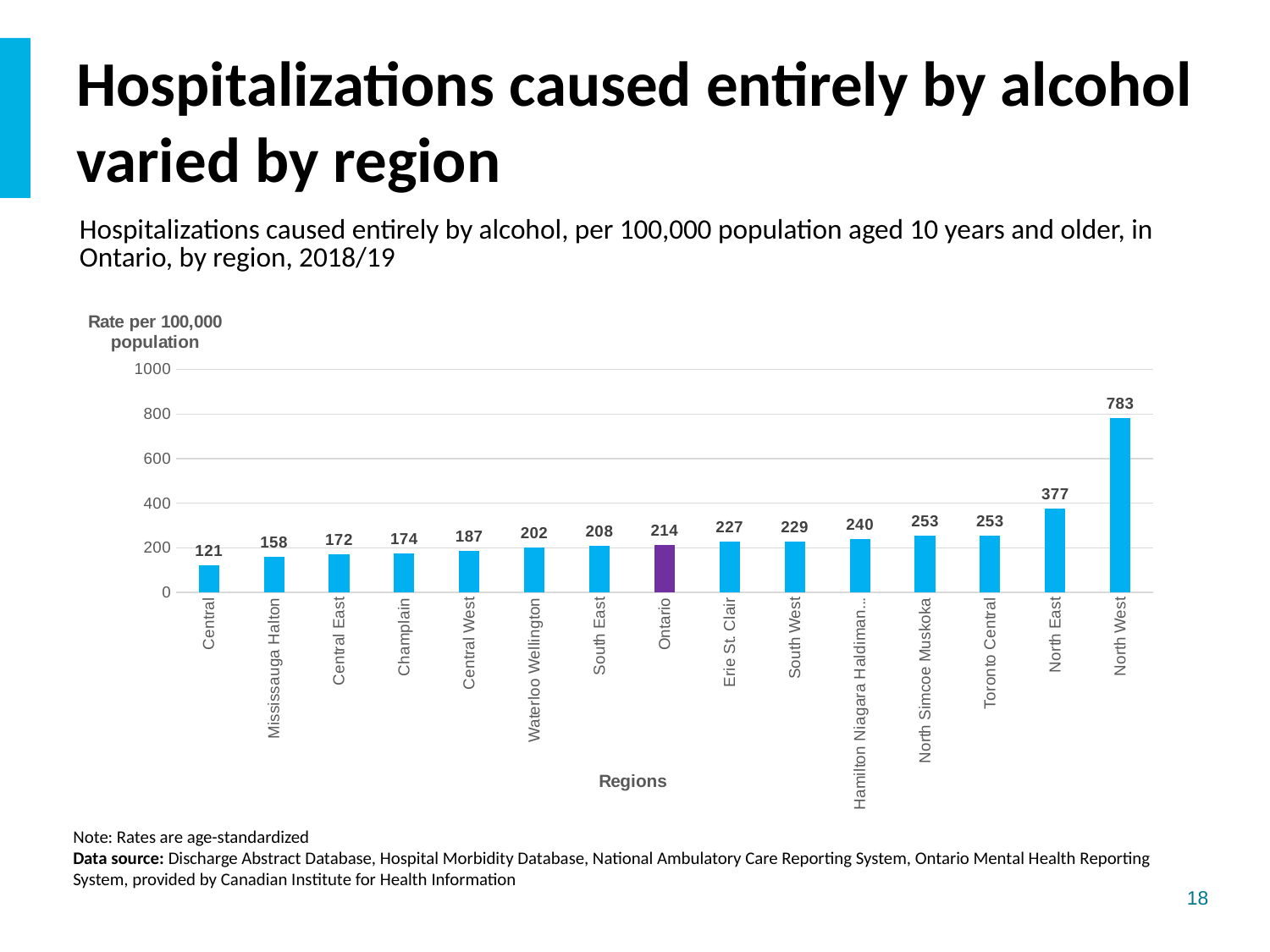
What is the rate for Waterloo Wellington? 202 What is the rate shown for Ontario overall? 214 What is the difference between the rates for Ontario and Central? 93 What is the hospitalization rate per 100,000 population for North West? 783 How many bars are plotted in the chart? 15 Which region has the highest hospitalization rate? North West What type of chart is shown on the slide? Bar chart Do the values rise or fall from left to right along the x axis? Rise Is the value for North East greater or less than 400? less Which region has the lowest hospitalization rate? Central Which has a higher rate, Erie St. Clair or Champlain? Erie St. Clair What is the difference between the rates for North West and North East? 406